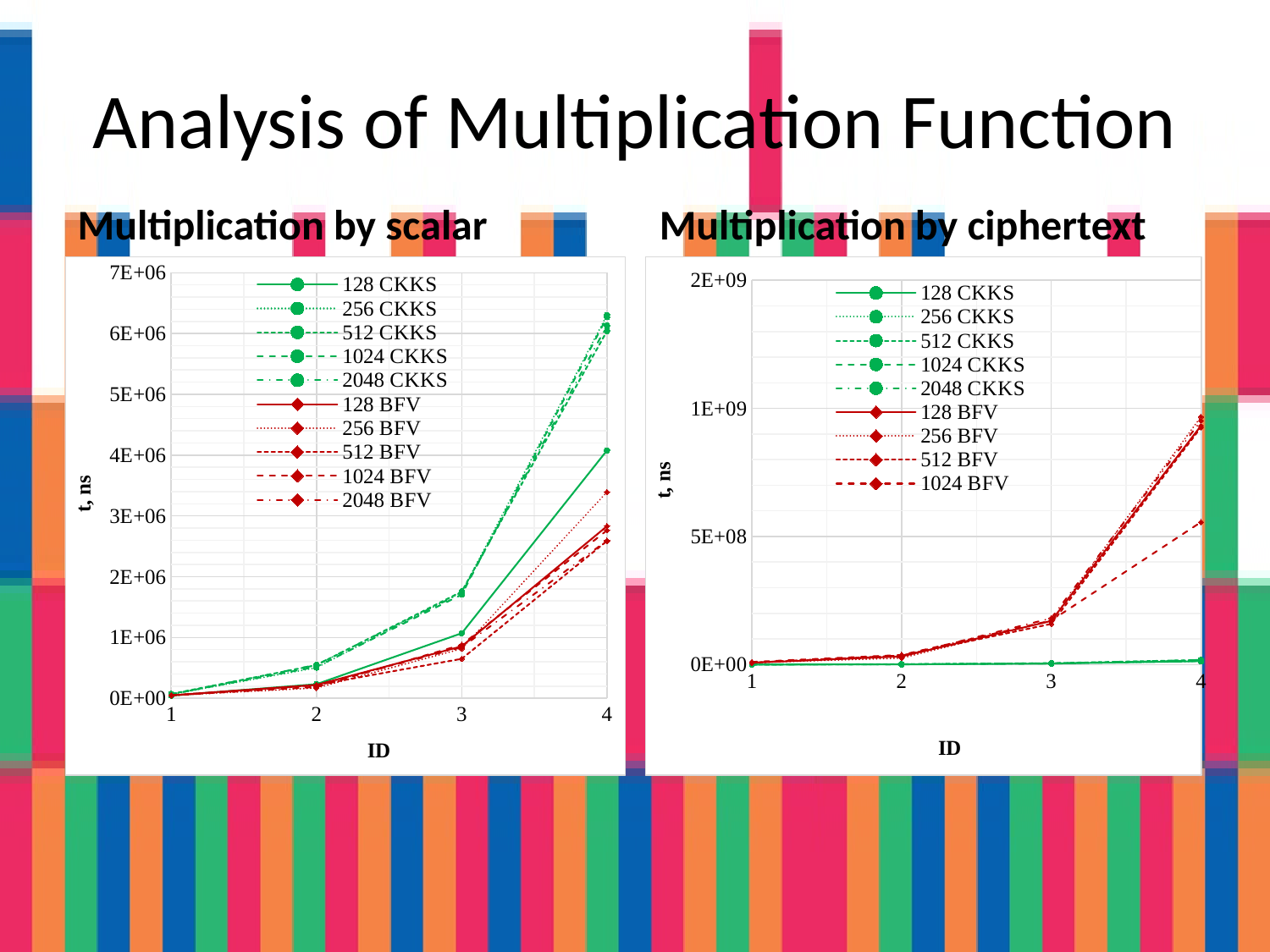
How many series does the legend of the "Multiplication by scalar" chart list? 10 How many series does the legend of the "Multiplication by ciphertext" chart list? 9 In the "Multiplication by scalar" chart, which is larger at ID 4: 128 CKKS or 128 BFV? 128 CKKS In the "Multiplication by scalar" chart, is the value for 128 CKKS at ID 4 greater or less than 3E+06? greater In the "Multiplication by ciphertext" chart, is the value for 1024 BFV at ID 4 greater or less than 5E+08? greater In the "Multiplication by scalar" chart, is the value for 128 BFV at ID 4 greater or less than 3E+06? less How many ID values are plotted along the x axis of the "Multiplication by ciphertext" chart? 4 In the "Multiplication by scalar" chart, do the values for 128 CKKS rise or fall as ID increases from 1 to 4? Rise In the "Multiplication by ciphertext" chart, which is larger at ID 4: 128 BFV or 1024 BFV? 128 BFV What is the y-axis title of the "Multiplication by ciphertext" chart? t, ns What type of chart is the "Multiplication by scalar" chart? Line chart